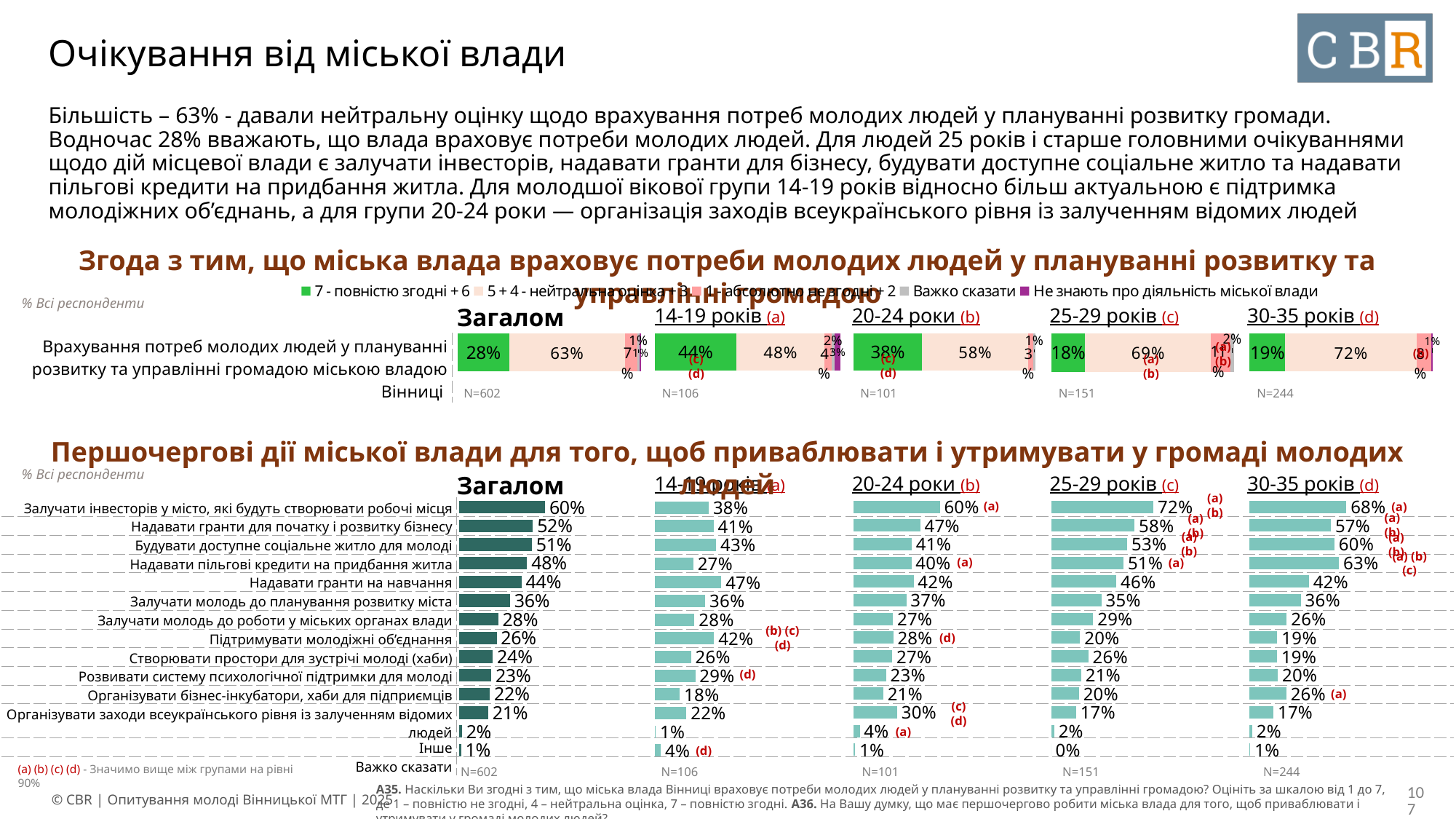
In the top chart, what share of all respondents (Загалом) gave a neutral rating ('5 + 4 - нейтральна оцінка + 3')? 63% In the bottom chart, for Загалом, what is the difference between 'Залучати інвесторів у місто' and 'Надавати гранти для початку і розвитку бізнесу'? 8 percentage points In the top chart, which age group has the highest share of '7 - повністю згодні + 6'? 14-19 років What type of chart is used in the bottom section of the slide (Першочергові дії міської влади)? Bar chart In the top chart, how many series does the legend list? 5 In the bottom chart, which group has the larger value for 'Організувати заходи всеукраїнського рівня із залученням відомих людей': 20-24 роки or 25-29 років? 20-24 роки In the bottom chart (Першочергові дії міської влади), what is the Загалом value for 'Залучати інвесторів у місто, які будуть створювати робочі місця'? 60% In the top chart, what is the neutral rating share for the 30-35 років group? 72% In the bottom chart, what is the value for 'Залучати інвесторів у місто' in the 25-29 років group? 72% In the bottom chart, which age group has the highest value for 'Залучати інвесторів у місто'? 25-29 років In the top chart (Згода з тим, що міська влада враховує потреби молодих людей), what share of all respondents (Загалом) gave the answer '7 - повністю згодні + 6'? 28% In the bottom chart, what is the value for 'Підтримувати молодіжні об'єднання' in the 14-19 років group? 42%